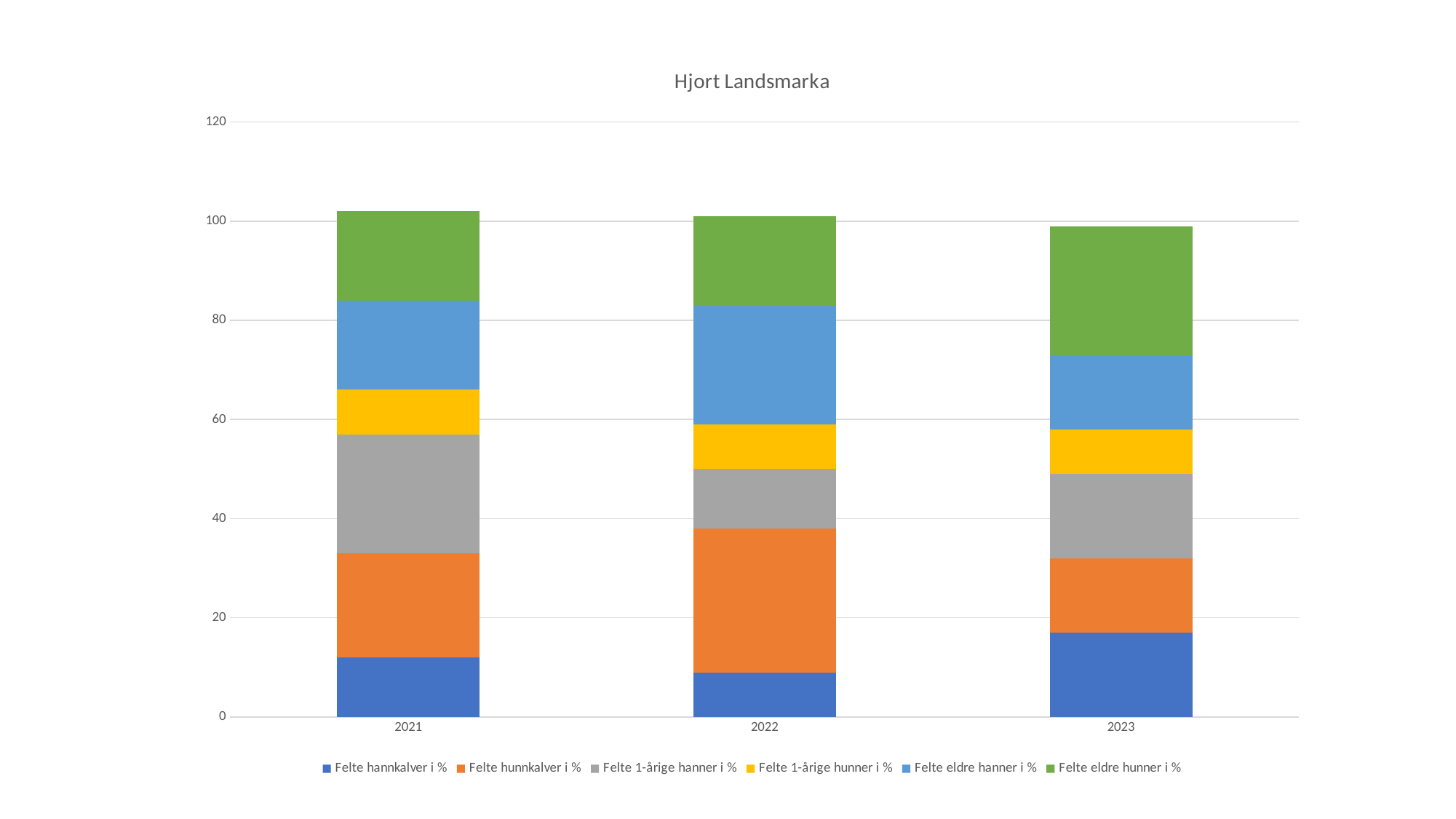
Which year has the smallest Felte hannkalver i % segment? 2022 Is the value for Felte hannkalver i % in 2022 greater or less than 20? less Is the value for Felte hannkalver i % in 2023 greater or less than 20? less What type of chart is shown on the slide? Stacked bar chart Which year has the largest Felte hannkalver i % segment? 2023 Is the Felte eldre hunner i % segment larger in 2023 or in 2021? 2023 How many years are shown on the x axis of the chart? 3 How many series does the legend list? 6 Which series is shown in green in the chart? Felte eldre hunner i % What is the title of the chart? Hjort Landsmarka Is the Felte eldre hanner i % segment larger in 2022 or in 2023? 2022 Which year has the largest Felte hunnkalver i % segment? 2022